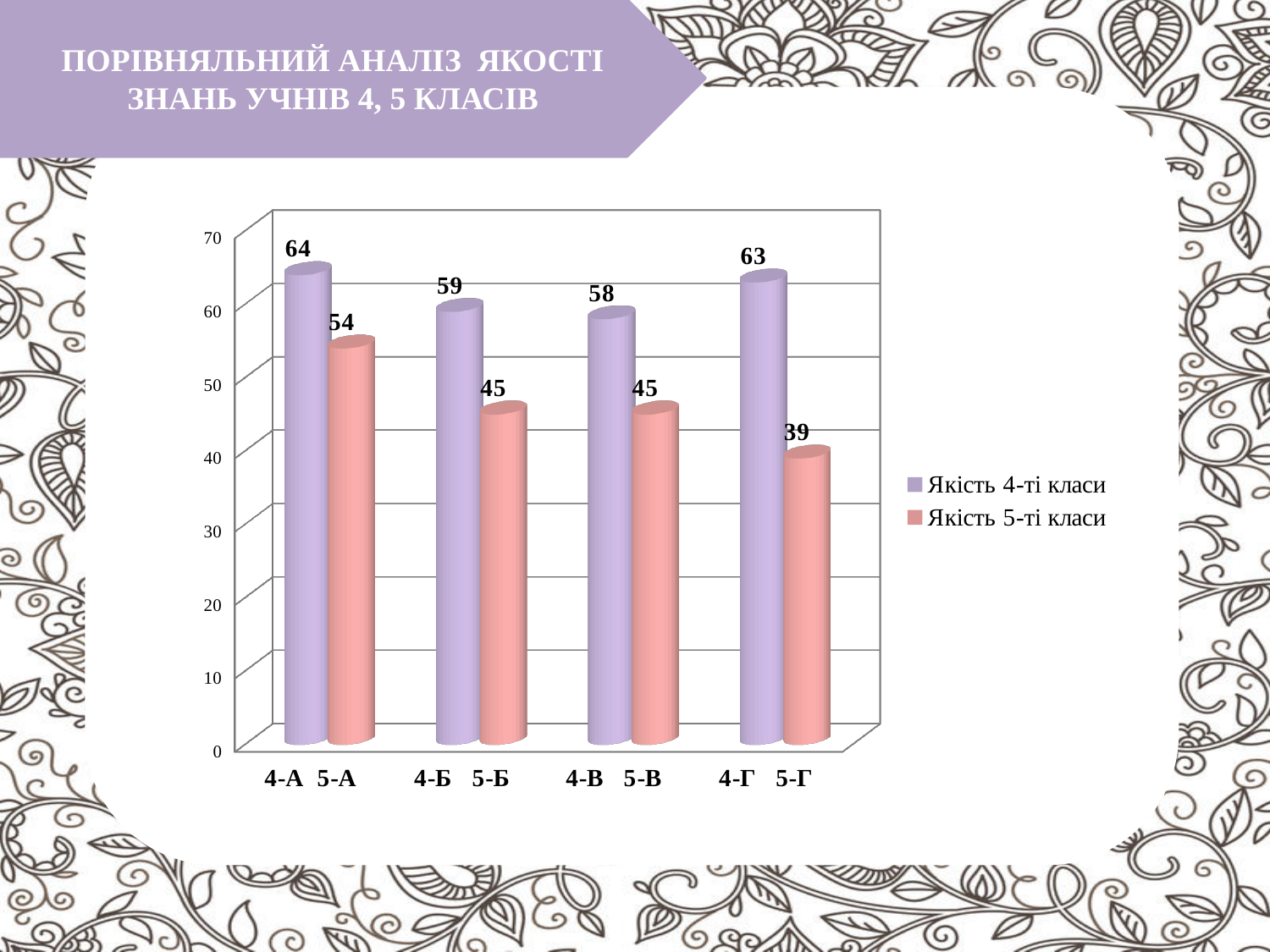
Which class has the highest value in the chart? 4-А What kind of chart is shown on the slide? bar chart What is the value for 5-Б in the chart? 45 Is the value for 5-А greater or less than 50? greater What is the difference between the values for 4-А and 5-А? 10 What is the value for 5-Г in the chart? 39 What is the difference between the values for 4-Г and 5-Г? 24 Which is larger, the value for 4-Б or the value for 4-В? 4-Б How many series does the legend list? 2 Which class has the lowest value in the chart? 5-Г Which legend entry is shown in pink? Якість 5-ті класи What is the value for 4-А in the chart? 64